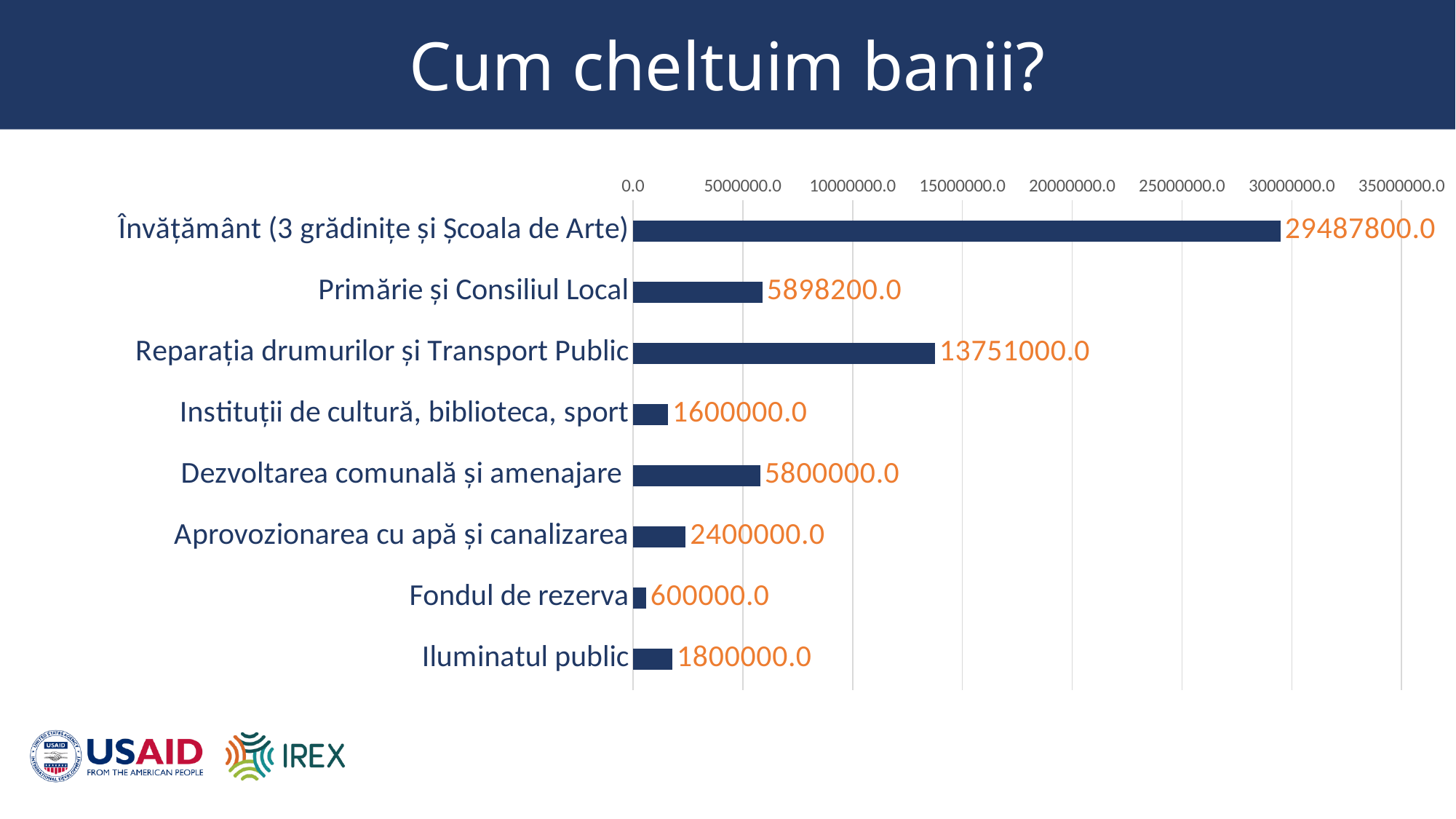
What is the value for Aprovozionarea cu apă și canalizarea? 2400000.0 What is the value for Fondul de rezerva? 600000.0 Which category has the lowest value? Fondul de rezerva Which category has the highest value? Învățământ (3 grădinițe și Școala de Arte) Which is larger, the value for Iluminatul public or the value for Instituții de cultură, biblioteca, sport? Iluminatul public How many categories are shown in the chart? 8 What is the difference between the values for Învățământ (3 grădinițe și Școala de Arte) and Reparația drumurilor și Transport Public? 15736800.0 What is the value for Învățământ (3 grădinițe și Școala de Arte)? 29487800.0 Is the value for Reparația drumurilor și Transport Public greater or less than 15000000.0? less What kind of chart is shown on the slide? bar chart What is the value for Reparația drumurilor și Transport Public? 13751000.0 What is the difference between the values for Primărie și Consiliul Local and Dezvoltarea comunală și amenajare? 98200.0